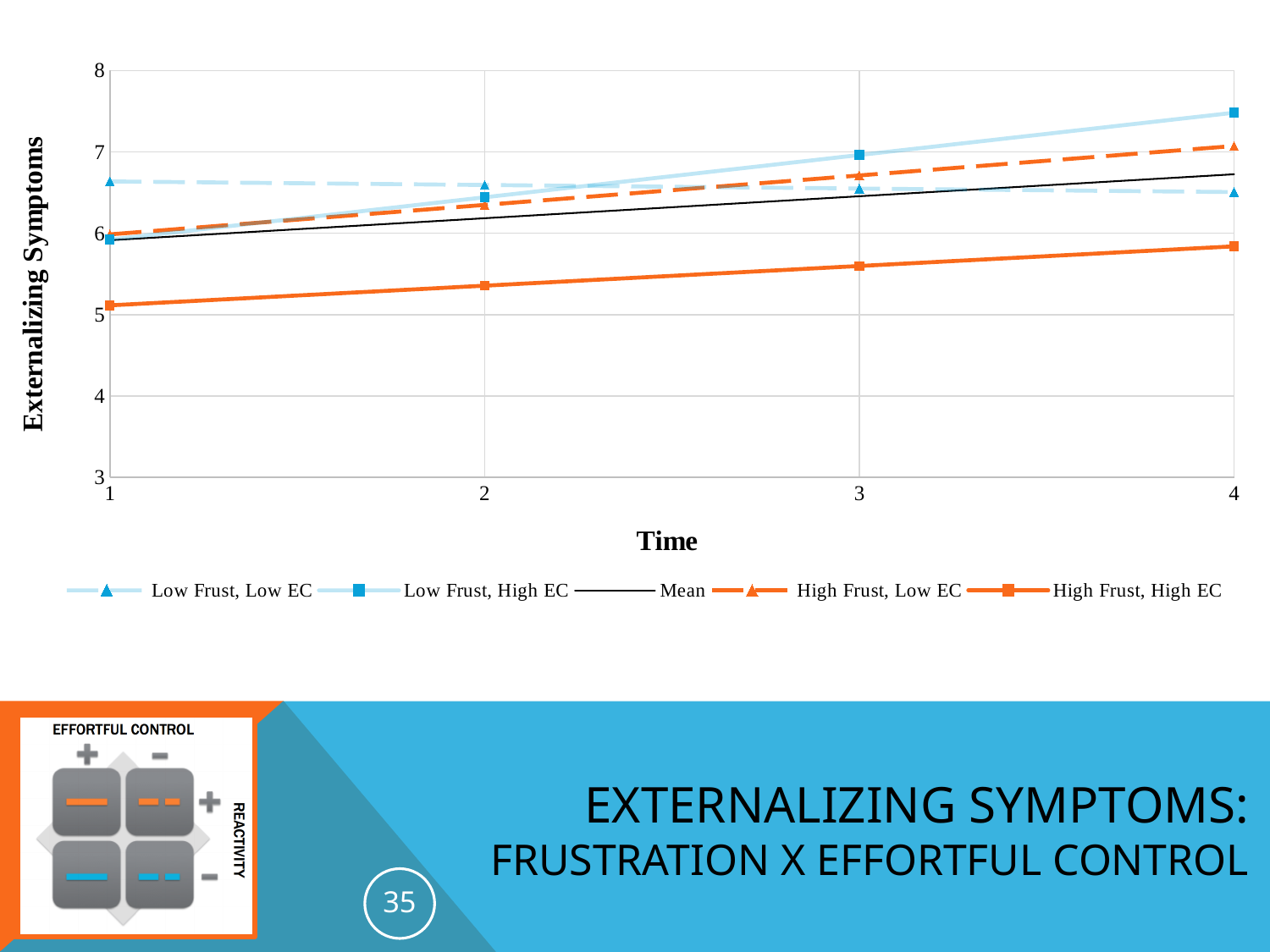
Is the value for Low Frust, High EC at time 4 greater or less than 7? greater At time 3, which is larger: Low Frust, High EC or High Frust, High EC? Low Frust, High EC Which series has the lowest value at time 1? High Frust, High EC How many time points are plotted along the x axis? 4 What is the title of the y axis? Externalizing Symptoms What is the title of the x axis? Time Does the Low Frust, High EC series rise or fall from time 1 to time 4? rise What kind of chart is shown on the slide? line chart Which series has the highest value at time 4? Low Frust, High EC Is the value for High Frust, High EC at time 1 greater or less than 6? less Is the value for Low Frust, Low EC at time 1 greater or less than 6? greater How many series does the legend list? 5